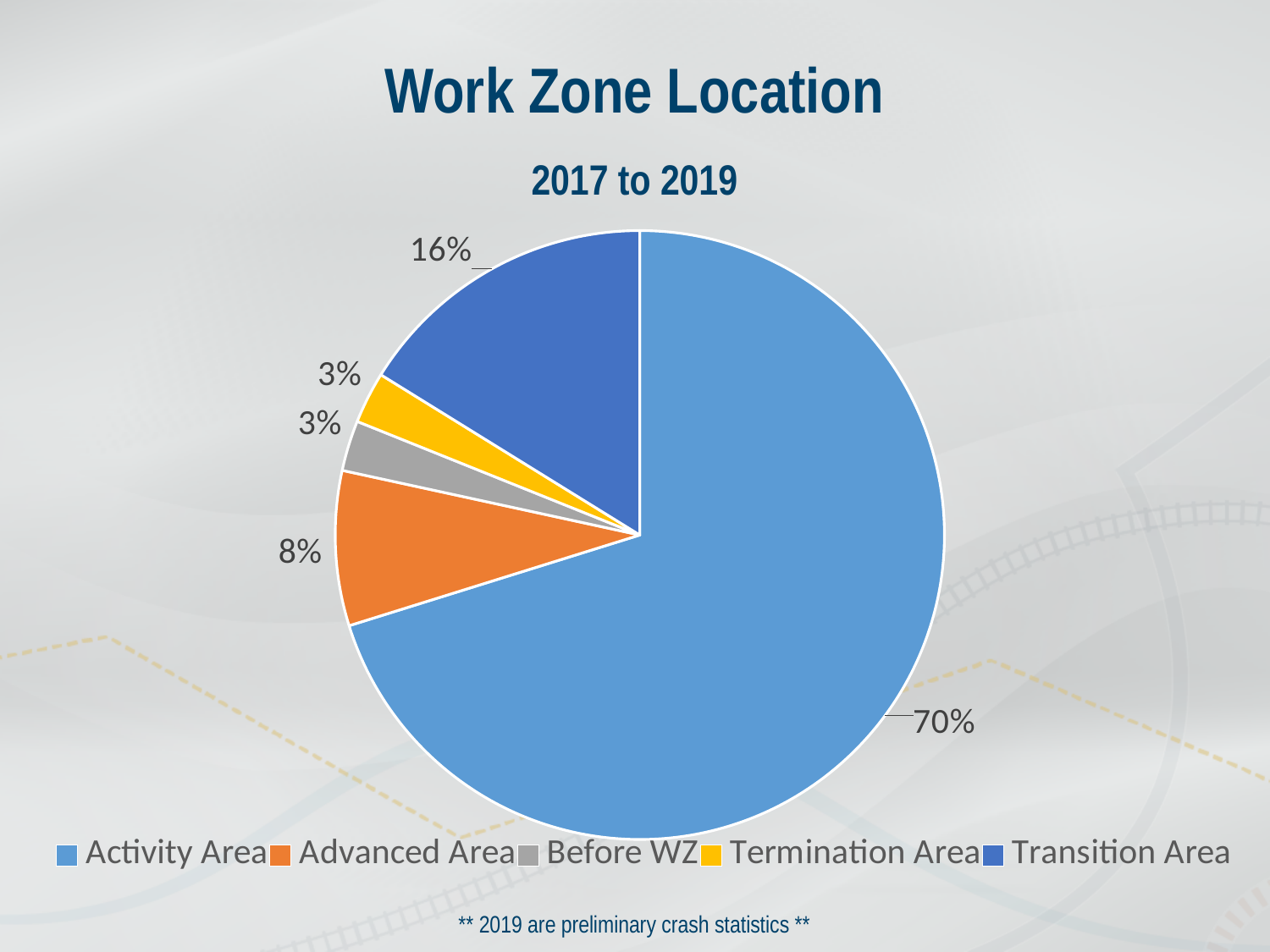
What is the title shown directly above the pie chart? 2017 to 2019 What share of the pie does Transition Area represent? 16% How many categories does the legend list? 5 What share of the pie does Activity Area represent? 70% What is the difference in percentage points between the Activity Area slice and the Transition Area slice? 54 Which is larger, the slice for Transition Area or the slice for Advanced Area? Transition Area What is the difference in percentage points between the Advanced Area slice and the Before WZ slice? 5 What share of the pie does Termination Area represent? 3% What kind of chart is shown on the slide? pie chart Which category has the largest slice of the pie? Activity Area